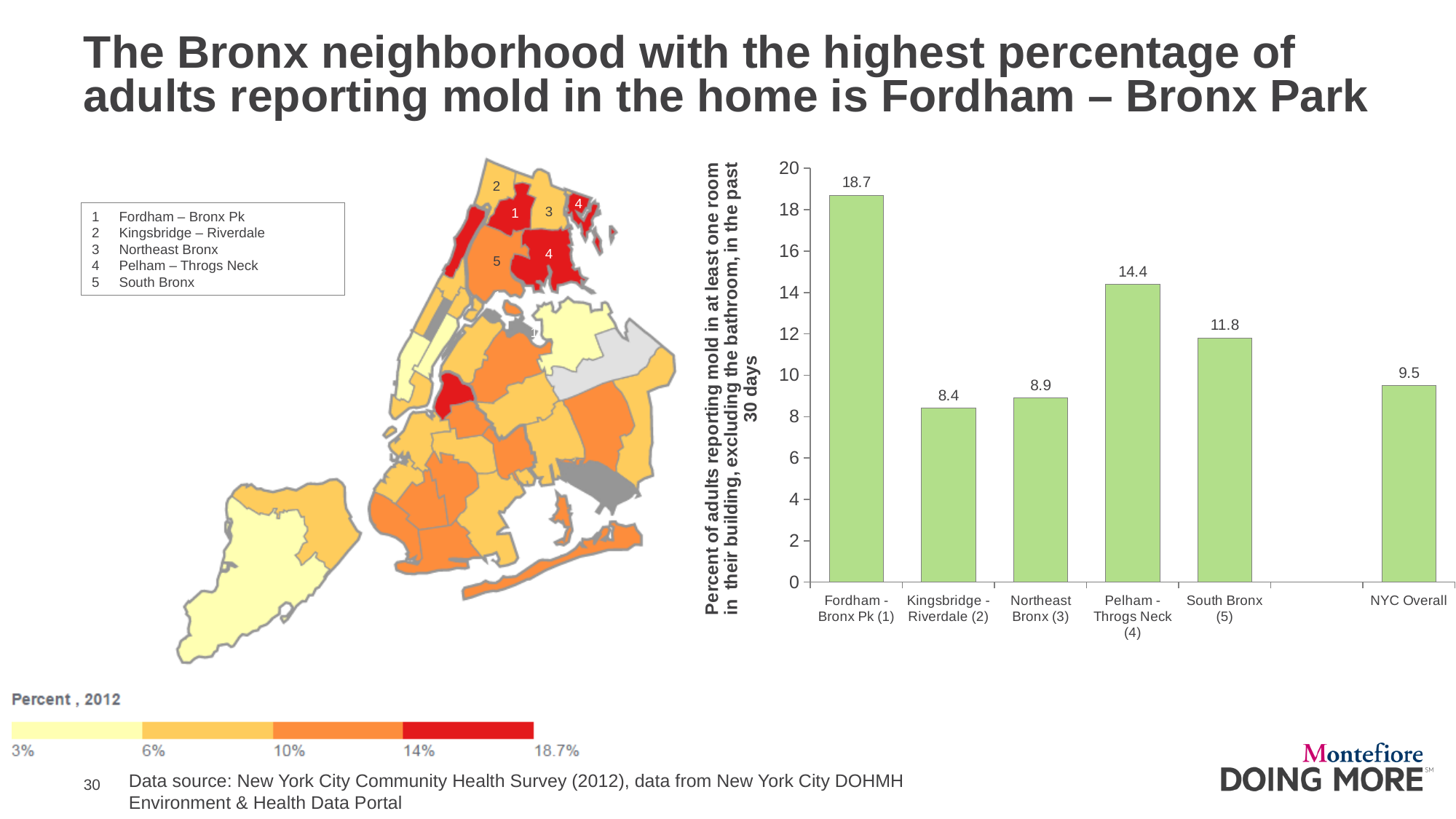
What is the difference between the values for Fordham - Bronx Pk (1) and South Bronx (5) in the bar chart? 6.9 Which category has the highest value in the bar chart? Fordham - Bronx Pk (1) What is the value for NYC Overall in the bar chart? 9.5 Is the value for South Bronx (5) in the bar chart greater or less than 10? greater What colour are the bars in the bar chart? green How many bars are shown in the bar chart? 6 Which category has the lowest value in the bar chart? Kingsbridge - Riverdale (2) What is the value for Fordham - Bronx Pk (1) in the bar chart? 18.7 What is the value for Pelham - Throgs Neck (4) in the bar chart? 14.4 What kind of chart is shown on the right side of the slide? bar chart What is the value for Kingsbridge - Riverdale (2) in the bar chart? 8.4 In the bar chart, which is larger: the value for Northeast Bronx (3) or NYC Overall? NYC Overall